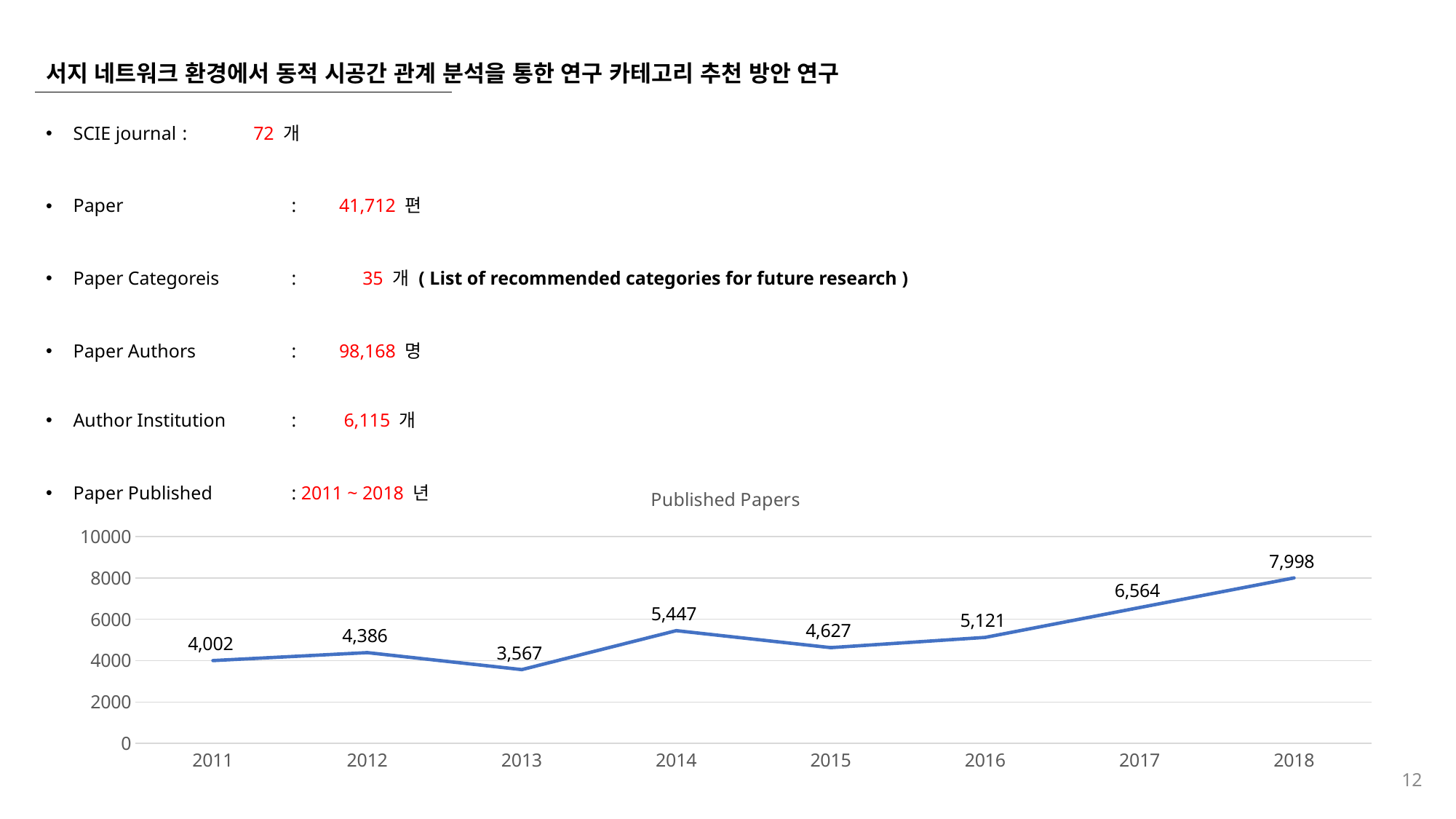
What is the title of the chart? Published Papers What is the value for 2011 in the Published Papers chart? 4,002 What is the value for 2014 in the Published Papers chart? 5,447 What kind of chart is shown on the slide? line chart What is the value for 2017 in the Published Papers chart? 6,564 Which is larger, the value for 2015 or the value for 2016? 2016 How many years are plotted in the Published Papers chart? 8 Is the value for 2013 greater or less than 4000? less Which year has the lowest number of published papers? 2013 Which year has the highest number of published papers? 2018 What is the difference between the values for 2014 and 2013? 1,880 What is the difference between the values for 2018 and 2017? 1,434